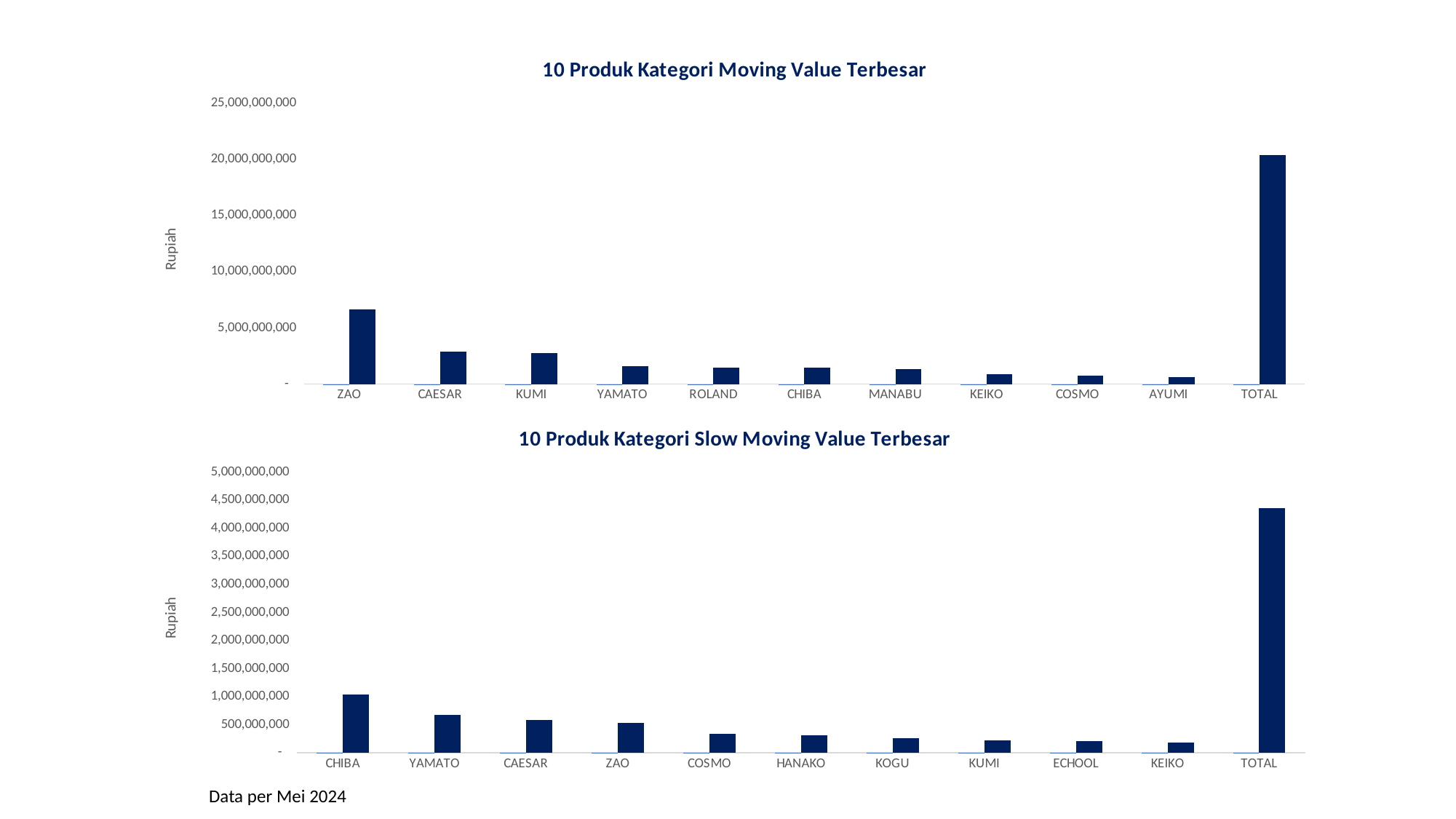
How many categories are shown on the x axis of the chart titled '10 Produk Kategori Moving Value Terbesar'? 11 In the chart titled '10 Produk Kategori Moving Value Terbesar', is the value for ZAO greater or less than 5,000,000,000? greater In the chart titled '10 Produk Kategori Moving Value Terbesar', what kind of chart is shown? bar chart In the chart titled '10 Produk Kategori Moving Value Terbesar', which category has the tallest bar? TOTAL In the chart titled '10 Produk Kategori Slow Moving Value Terbesar', which is larger, YAMATO or ZAO? YAMATO In the chart titled '10 Produk Kategori Moving Value Terbesar', which category has the lowest value? AYUMI In the chart titled '10 Produk Kategori Slow Moving Value Terbesar', is the value for TOTAL greater or less than 4,000,000,000? greater In the chart titled '10 Produk Kategori Slow Moving Value Terbesar', which category has the lowest value? KEIKO In the chart titled '10 Produk Kategori Moving Value Terbesar', which product (excluding TOTAL) has the highest value? ZAO What is the label on the vertical axis of the chart titled '10 Produk Kategori Slow Moving Value Terbesar'? Rupiah In the chart titled '10 Produk Kategori Slow Moving Value Terbesar', is the value for YAMATO greater or less than 500,000,000? greater